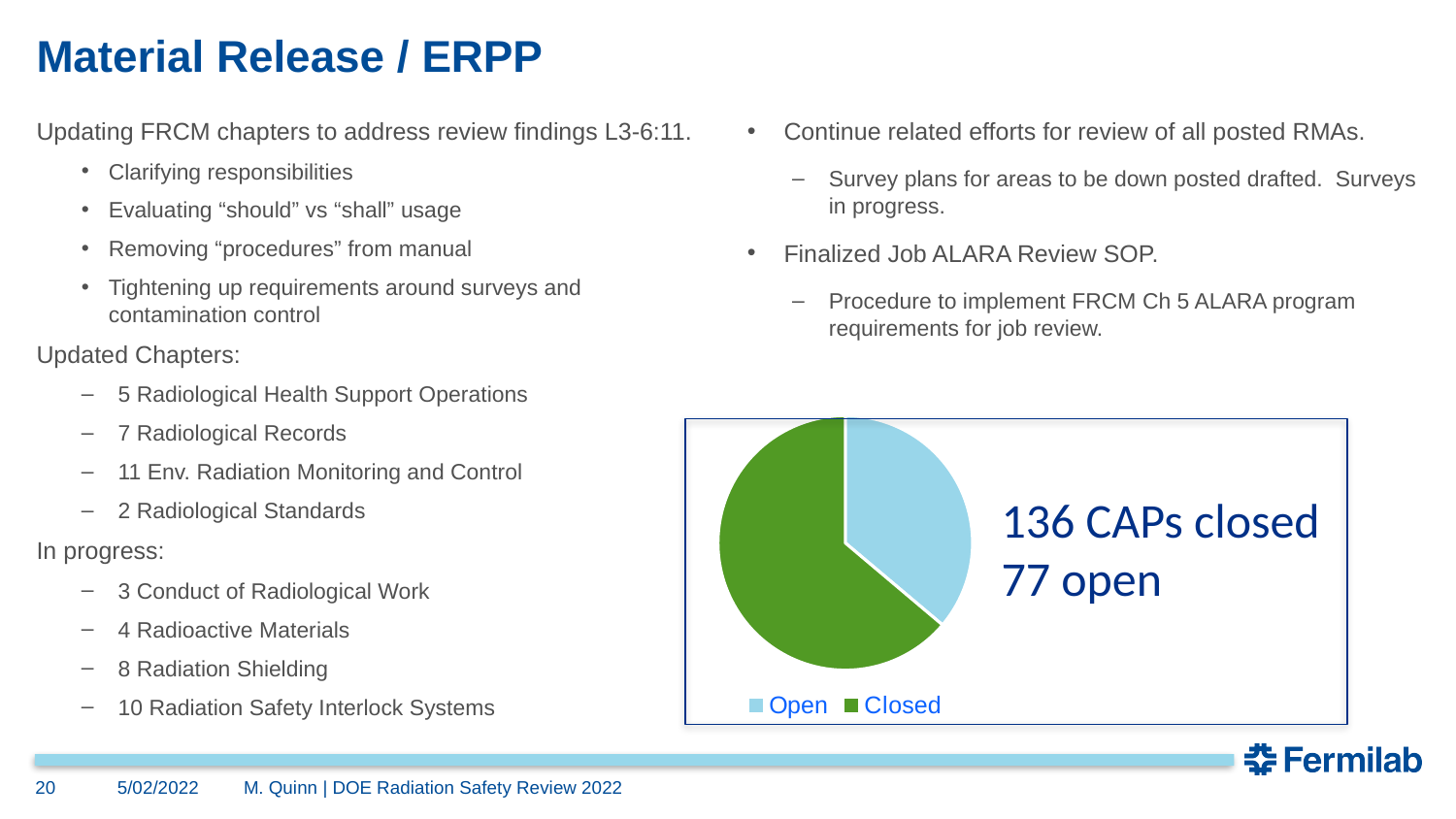
Is the number of closed CAPs larger or smaller than the number of open CAPs? Larger Which category has the smaller slice of the pie chart? Open What is the total number of CAPs represented in the pie chart? 213 Which category has the larger slice of the pie chart? Closed How many categories does the pie chart's legend list? 2 What are the two legend entries of the pie chart? Open and Closed How many CAPs are open according to the chart? 77 What colour represents the Open category in the pie chart? Light blue How many CAPs are closed according to the chart? 136 What kind of chart is shown on the slide? Pie chart What is the difference between the number of closed CAPs and open CAPs? 59